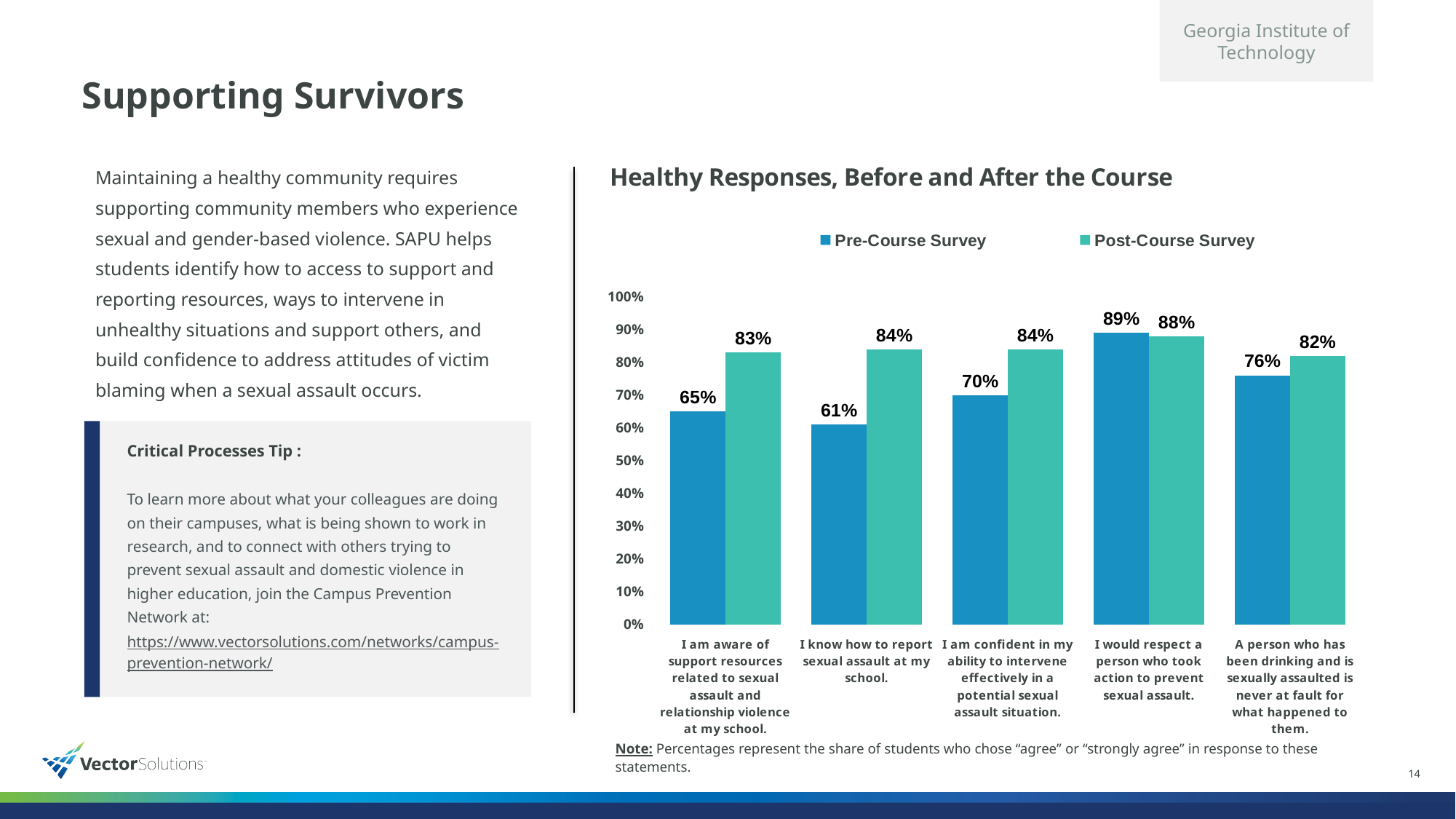
How many statements (categories) are shown on the x axis of the chart? 5 Which statement has the highest Pre-Course Survey value? I would respect a person who took action to prevent sexual assault. What is the difference between the Post-Course and Pre-Course Survey values for "I know how to report sexual assault at my school."? 23 percentage points What is the Pre-Course Survey value for "I am aware of support resources related to sexual assault and relationship violence at my school."? 65% How many series does the chart legend list? 2 Which statement has the lowest Pre-Course Survey value? I know how to report sexual assault at my school. For "I would respect a person who took action to prevent sexual assault.", which is larger: the Pre-Course Survey value or the Post-Course Survey value? Pre-Course Survey What is the title of the chart? Healthy Responses, Before and After the Course What is the Post-Course Survey value for "A person who has been drinking and is sexually assaulted is never at fault for what happened to them."? 82% What kind of chart is shown on the slide? Bar chart What is the Pre-Course Survey value for "I am confident in my ability to intervene effectively in a potential sexual assault situation."? 70% What is the Post-Course Survey value for "I know how to report sexual assault at my school."? 84%